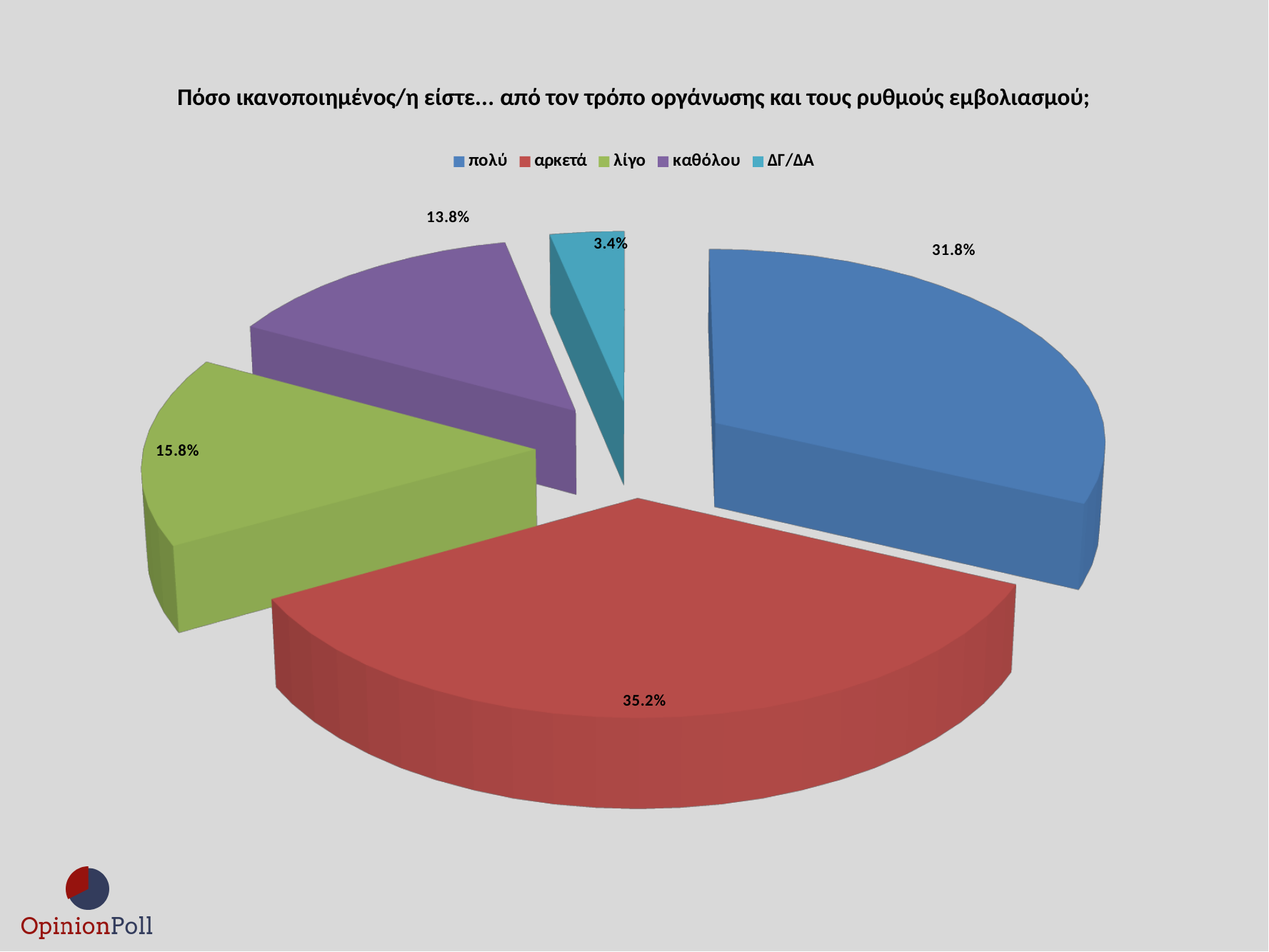
Which category has the smallest share of the pie? ΔΓ/ΔΑ Which category has the largest share of the pie? αρκετά What percentage is shown for the 'αρκετά' slice? 35.2% What percentage is shown for the 'καθόλου' slice? 13.8% What percentage is shown for the 'λίγο' slice? 15.8% What type of chart is shown on the slide? Pie chart Which is larger, the share for 'λίγο' or the share for 'καθόλου'? λίγο What is the difference in percentage points between 'αρκετά' and 'πολύ'? 3.4 What percentage is shown for the 'πολύ' slice? 31.8% What colour is the 'αρκετά' slice? Red What percentage is shown for the 'ΔΓ/ΔΑ' slice? 3.4% How many categories does the legend list? 5